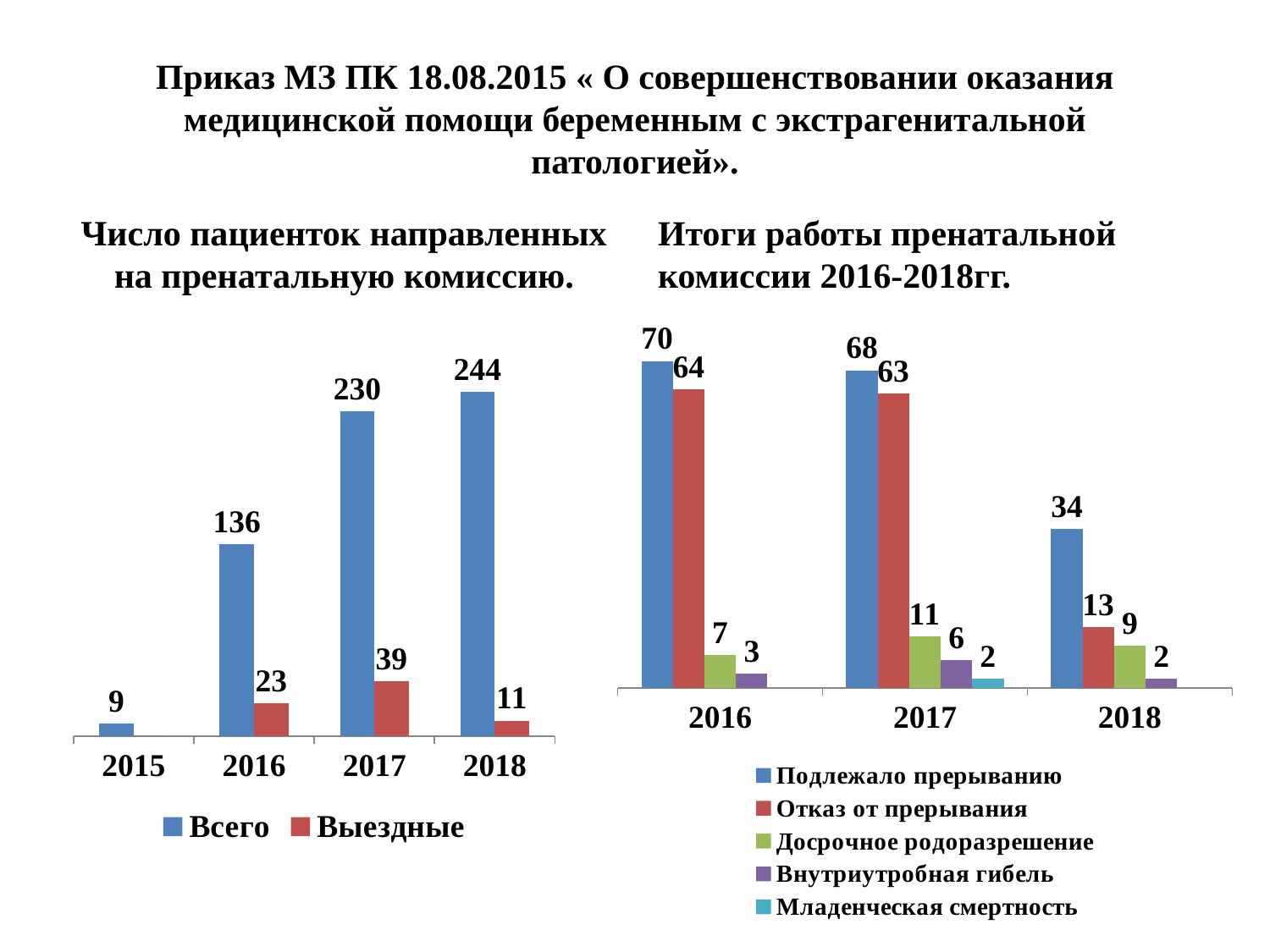
What kind of chart is the right chart 'Итоги работы пренатальной комиссии 2016-2018гг.'? bar chart In the right chart 'Итоги работы пренатальной комиссии 2016-2018гг.', what is the value of Досрочное родоразрешение for 2017? 11 In the left chart 'Число пациенток направленных на пренатальную комиссию', which year has the lowest value for Всего? 2015 In the left chart 'Число пациенток направленных на пренатальную комиссию', what is the value of Выездные for 2017? 39 In the right chart 'Итоги работы пренатальной комиссии 2016-2018гг.', which is larger in 2018: Отказ от прерывания or Досрочное родоразрешение? Отказ от прерывания In the left chart 'Число пациенток направленных на пренатальную комиссию', what is the difference between Всего in 2017 and Всего in 2016? 94 In the left chart 'Число пациенток направленных на пренатальную комиссию', does the value of Всего rise or fall from 2015 to 2018? rise In the right chart 'Итоги работы пренатальной комиссии 2016-2018гг.', how many series does the legend list? 5 In the left chart 'Число пациенток направленных на пренатальную комиссию', what is the value of Всего for 2018? 244 In the right chart 'Итоги работы пренатальной комиссии 2016-2018гг.', what is the value of Отказ от прерывания for 2016? 64 In the left chart 'Число пациенток направленных на пренатальную комиссию', how many series does the legend list? 2 In the right chart 'Итоги работы пренатальной комиссии 2016-2018гг.', which year has the highest value for Подлежало прерыванию? 2016